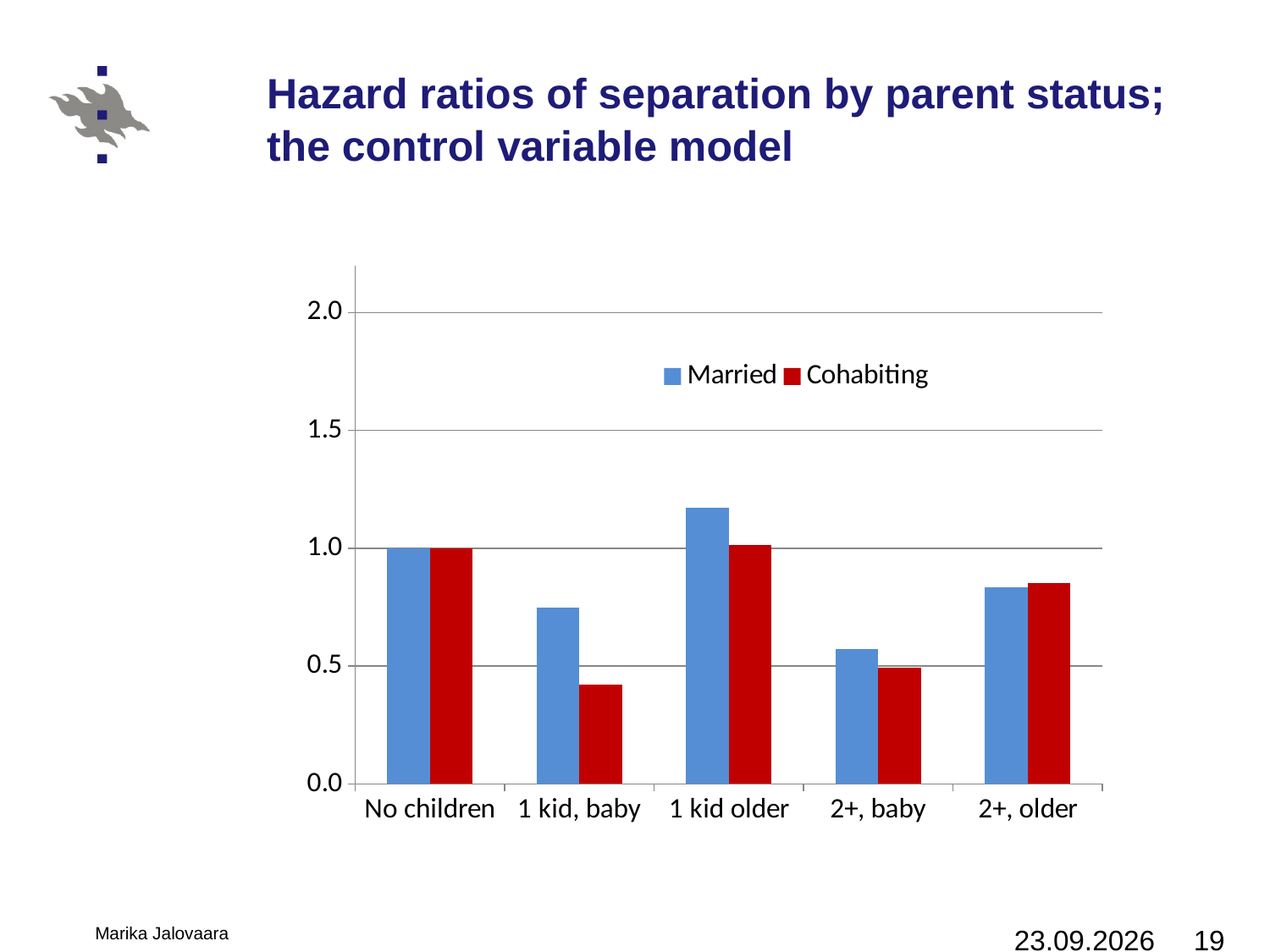
Is the Cohabiting value for 1 kid, baby greater or less than 0.5? less How many parent status categories are shown on the x axis? 5 Is the Married value for 2+, older greater or less than 1.0? less How many series does the legend list? 2 What is the hazard ratio for Married in the No children category? 1.0 What kind of chart is shown on the slide? bar chart Which category has the highest hazard ratio for Married? 1 kid older Which category has the lowest hazard ratio for Married? 2+, baby Is the Married value for 1 kid older greater or less than 1.0? greater Which colour represents the Cohabiting series? red In the 1 kid, baby category, which is larger: Married or Cohabiting? Married Which category has the lowest hazard ratio for Cohabiting? 1 kid, baby